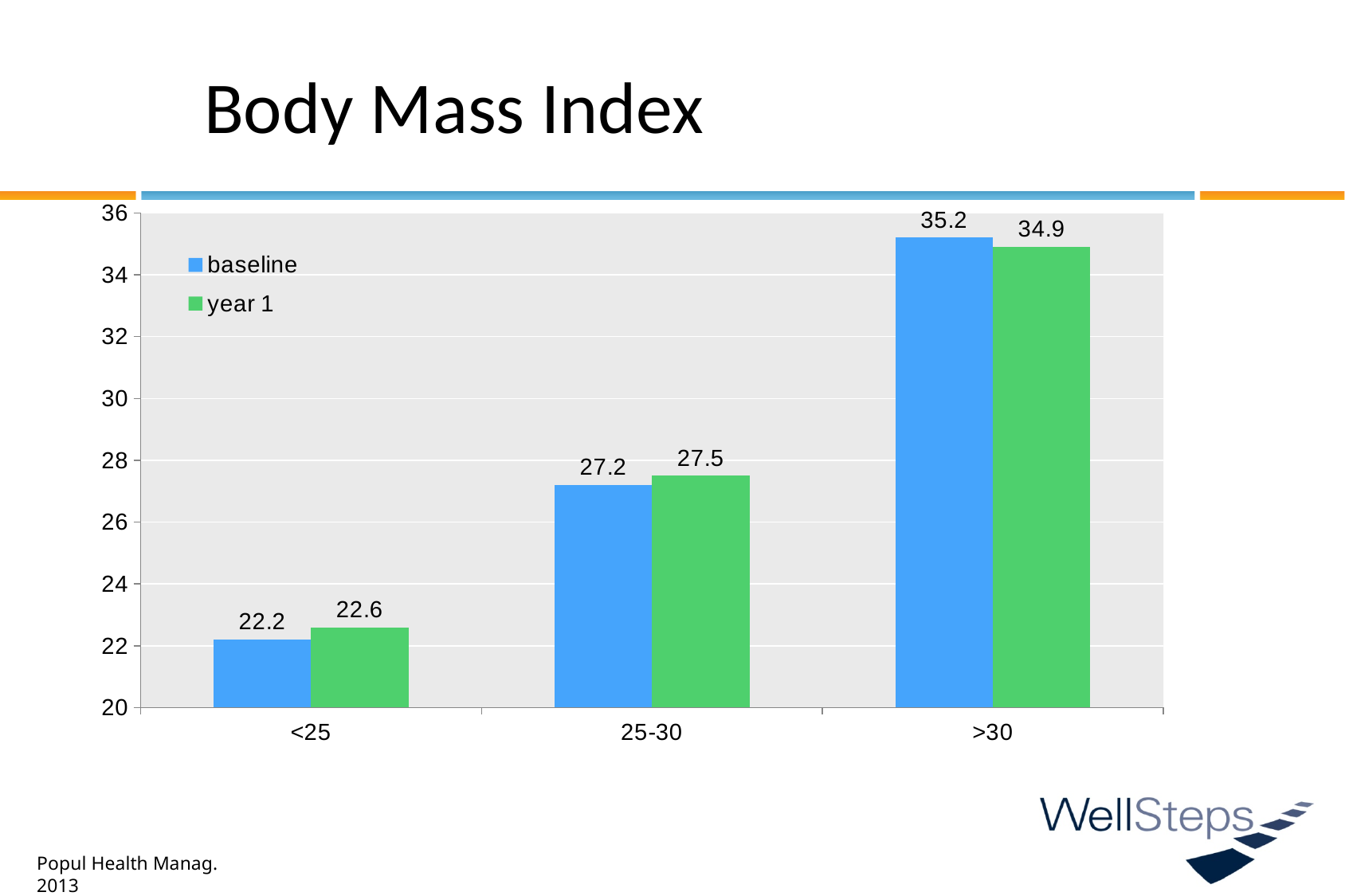
Which category has the lowest year 1 value? <25 How many categories are shown on the x axis? 3 How many series does the legend list? 2 What is the baseline value for the <25 category? 22.2 What is the baseline value for the >30 category? 35.2 What is the difference between the year 1 values for the 25-30 and <25 categories? 4.9 What is the difference between the baseline and year 1 values for the >30 category? 0.3 What is the year 1 value for the >30 category? 34.9 What kind of chart is shown on the slide? bar chart What is the title of the chart? Body Mass Index Which category has the highest baseline value? >30 What is the year 1 value for the 25-30 category? 27.5